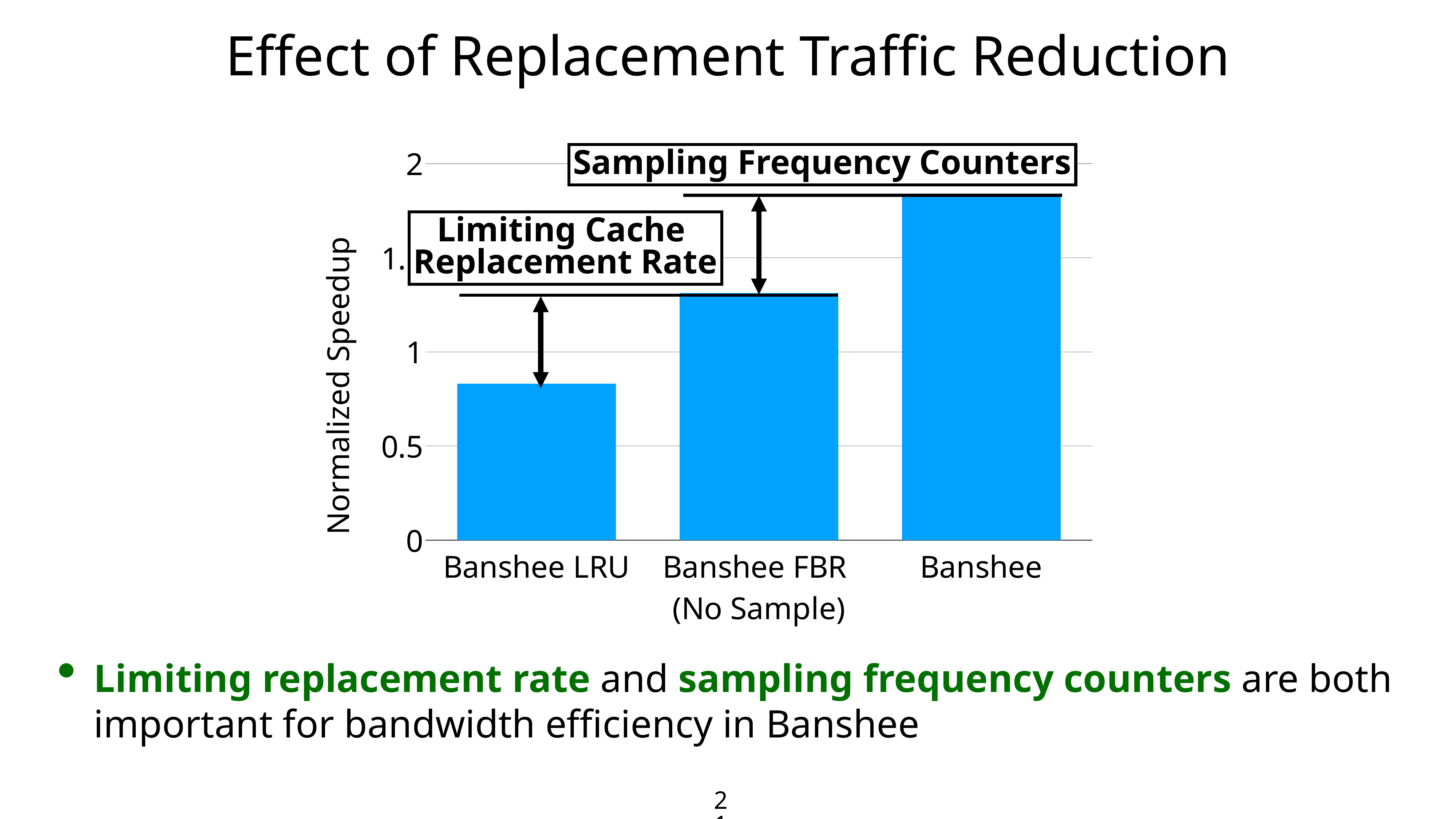
Is the value for Banshee greater or less than 2? less Is the value for Banshee greater or less than 1.5? greater What kind of chart is shown on the slide? bar chart What does the annotation between the Banshee FBR (No Sample) bar and the Banshee bar say? Sampling Frequency Counters Is the value for Banshee FBR (No Sample) greater or less than 1? greater Which category has the lowest normalized speedup? Banshee LRU What is the label of the vertical axis? Normalized Speedup How many bars are plotted in the chart? 3 Which has a higher normalized speedup, Banshee LRU or Banshee FBR (No Sample)? Banshee FBR (No Sample) Which category has the highest normalized speedup? Banshee Do the bar values rise or fall from left to right across the categories? rise